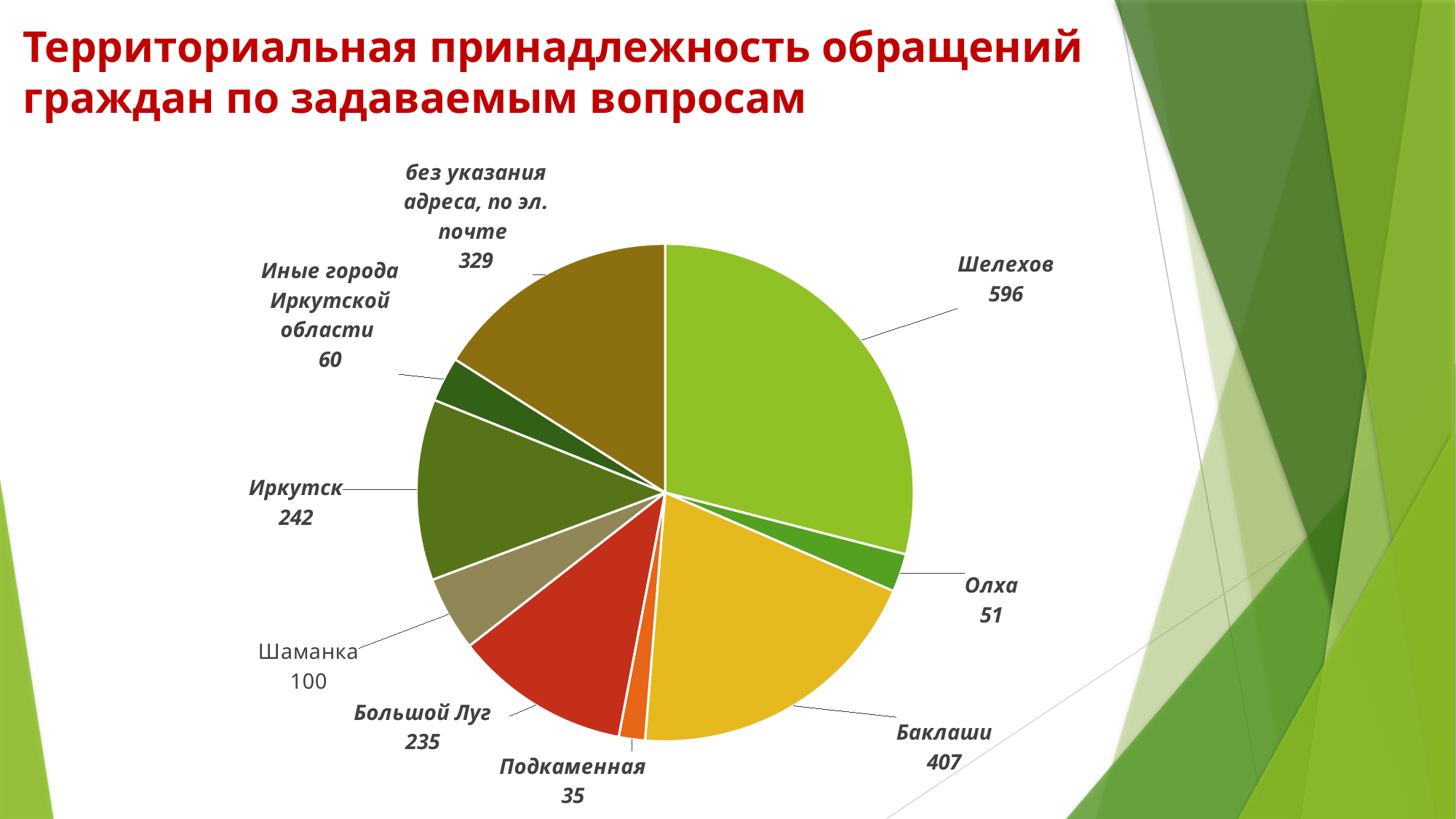
What share of the total does the Шелехов slice represent, rounded to the nearest whole percent? 29% What is the value for the slice labelled 'без указания адреса, по эл. почте'? 329 Which category has the smallest slice of the pie? Подкаменная What is the title of the slide? Территориальная принадлежность обращений граждан по задаваемым вопросам Which is larger, the value for Иркутск or the value for Большой Луг? Иркутск What kind of chart is shown on the slide? pie chart Which category has the largest slice of the pie? Шелехов How many slices does the pie chart have? 9 What is the value for Шелехов? 596 What is the value for Баклаши? 407 What is the value for Шаманка? 100 What is the difference between the values for Шелехов and Баклаши? 189